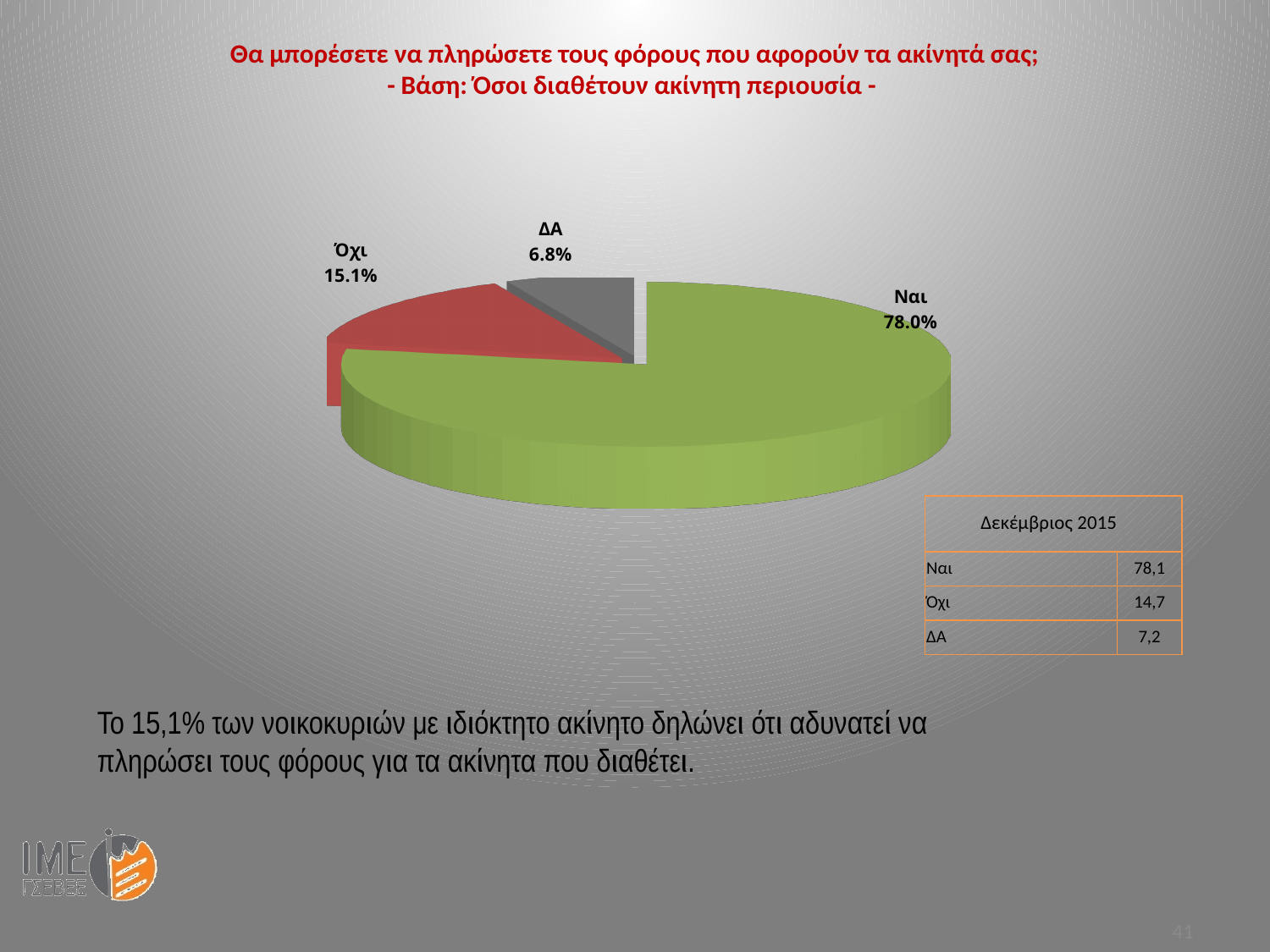
Which category has the smallest slice of the pie? ΔΑ What is the value for the Ναι slice? 78.0% How many slices does the pie chart have? 3 What is the difference between the Ναι and Όχι values? 62.9% What colour is the Όχι slice of the pie? red What is the difference between the Όχι and ΔΑ values? 8.3% Which category has the largest slice of the pie? Ναι What colour is the Ναι slice of the pie? green What is the value for the ΔΑ slice? 6.8% What is the value for the Όχι slice? 15.1% What type of chart is shown on the slide? pie chart Which is larger, the Όχι slice or the ΔΑ slice? Όχι